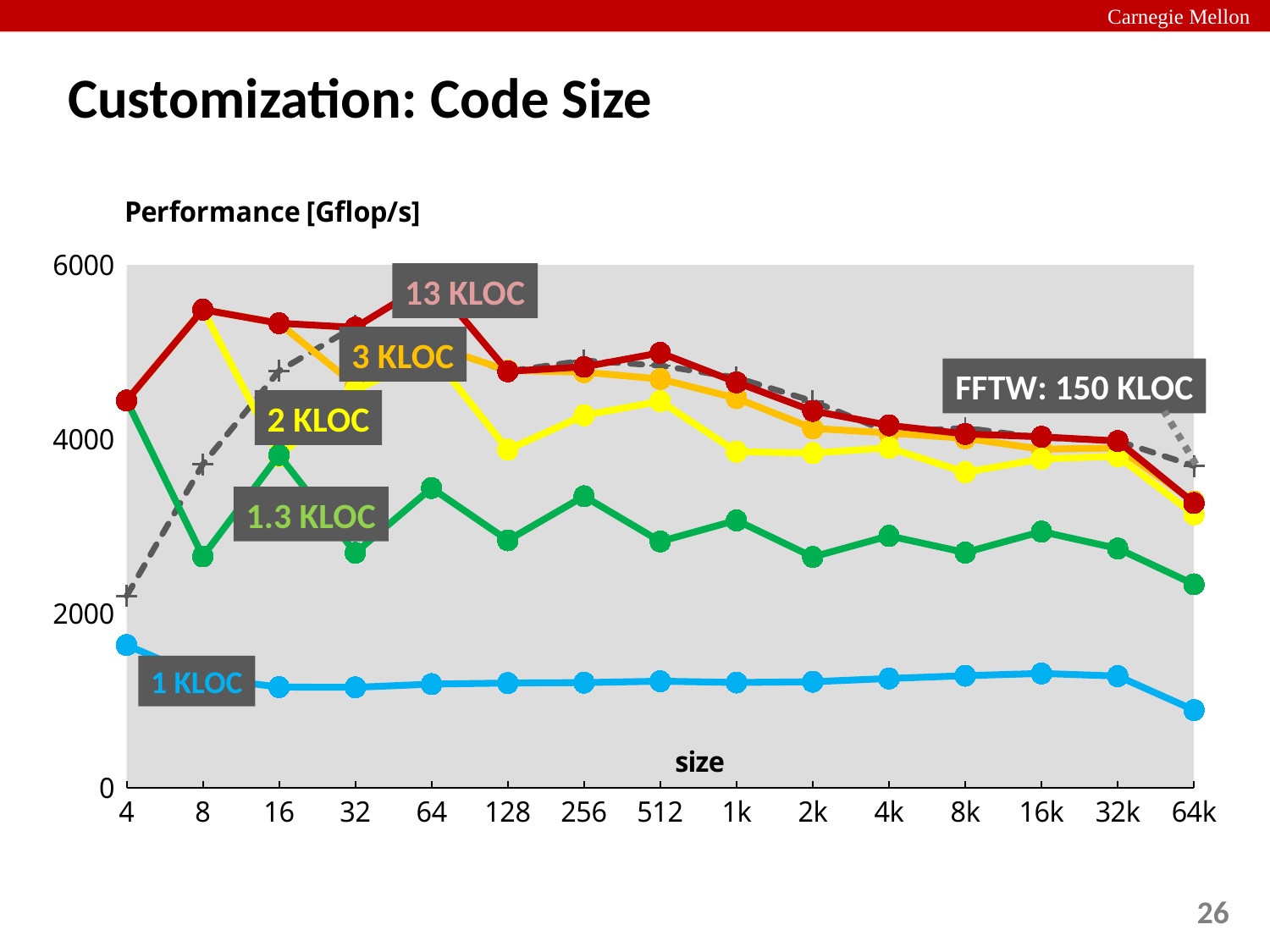
How many labeled series are plotted on the chart? 6 At size 64k, which series has the higher value, 13 KLOC or 1.3 KLOC? 13 KLOC Is the value for the 1 KLOC series at size 64k greater or less than 2000? less At size 4, which series has the higher value, 13 KLOC or FFTW: 150 KLOC? 13 KLOC How many size values are shown along the x axis? 15 What kind of chart is shown on the slide? line chart What is the label of the vertical axis of the chart? Performance [Gflop/s] Which series has the lowest values across the whole chart? 1 KLOC Is the value for the FFTW: 150 KLOC series at size 4 greater or less than 4000? less Does the 1 KLOC series rise or fall from size 32k to size 64k? fall Is the value for the 1.3 KLOC series at size 4 greater or less than 4000? greater